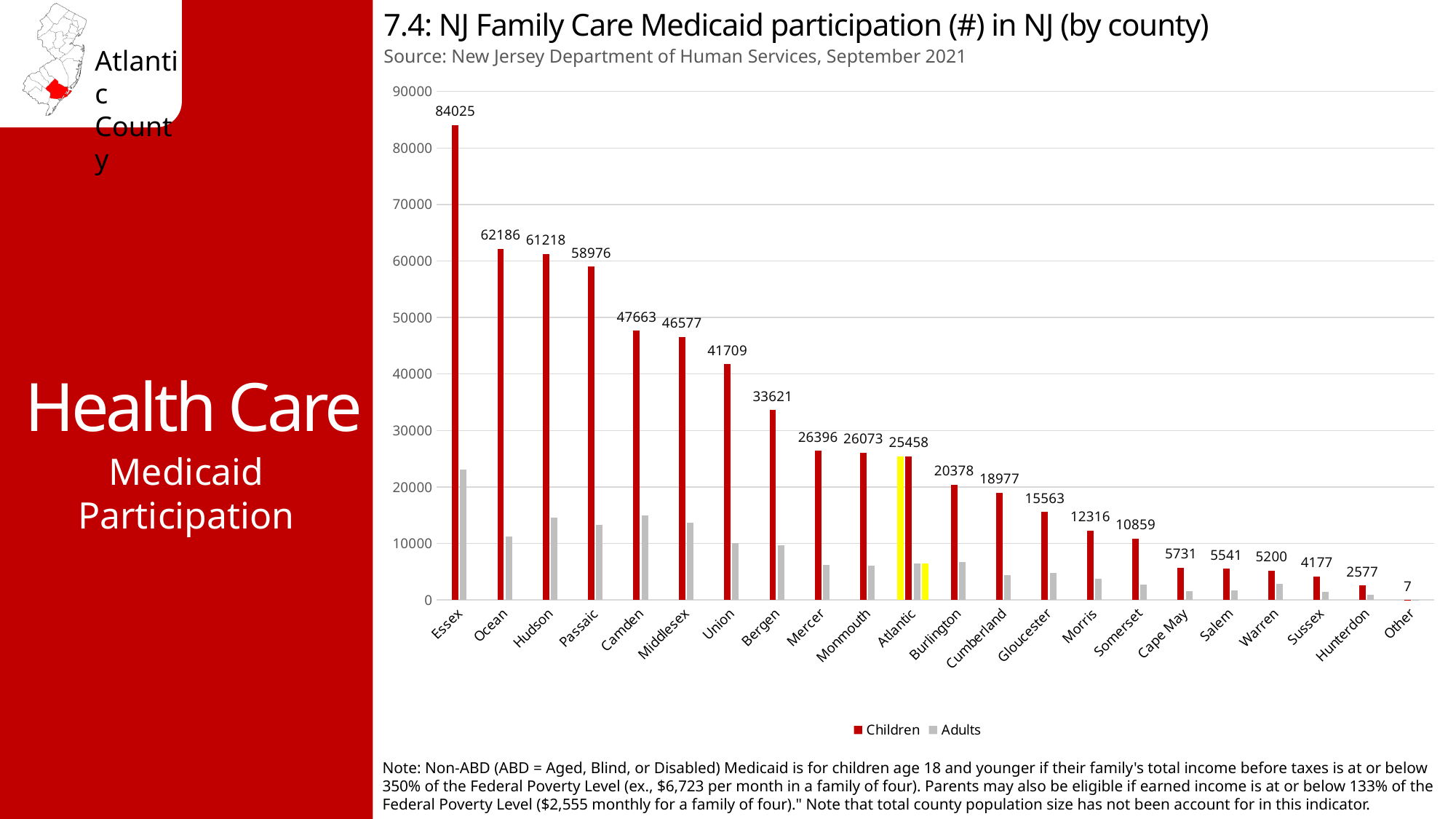
Is the Adults value for Essex greater or less than 20000? greater What is the Children value for Essex? 84025 Is the Adults value for Camden greater or less than 10000? greater How many series does the legend list? 2 What kind of chart is shown? Bar chart Which county has the highest Children value? Essex How many categories are shown on the x axis? 22 Which has a larger Children value, Camden or Union? Camden What is the Children value for Atlantic? 25458 Which category has the lowest Children value? Other What is the Children value for Cape May? 5731 What is the difference between the Children values for Ocean and Hudson? 968